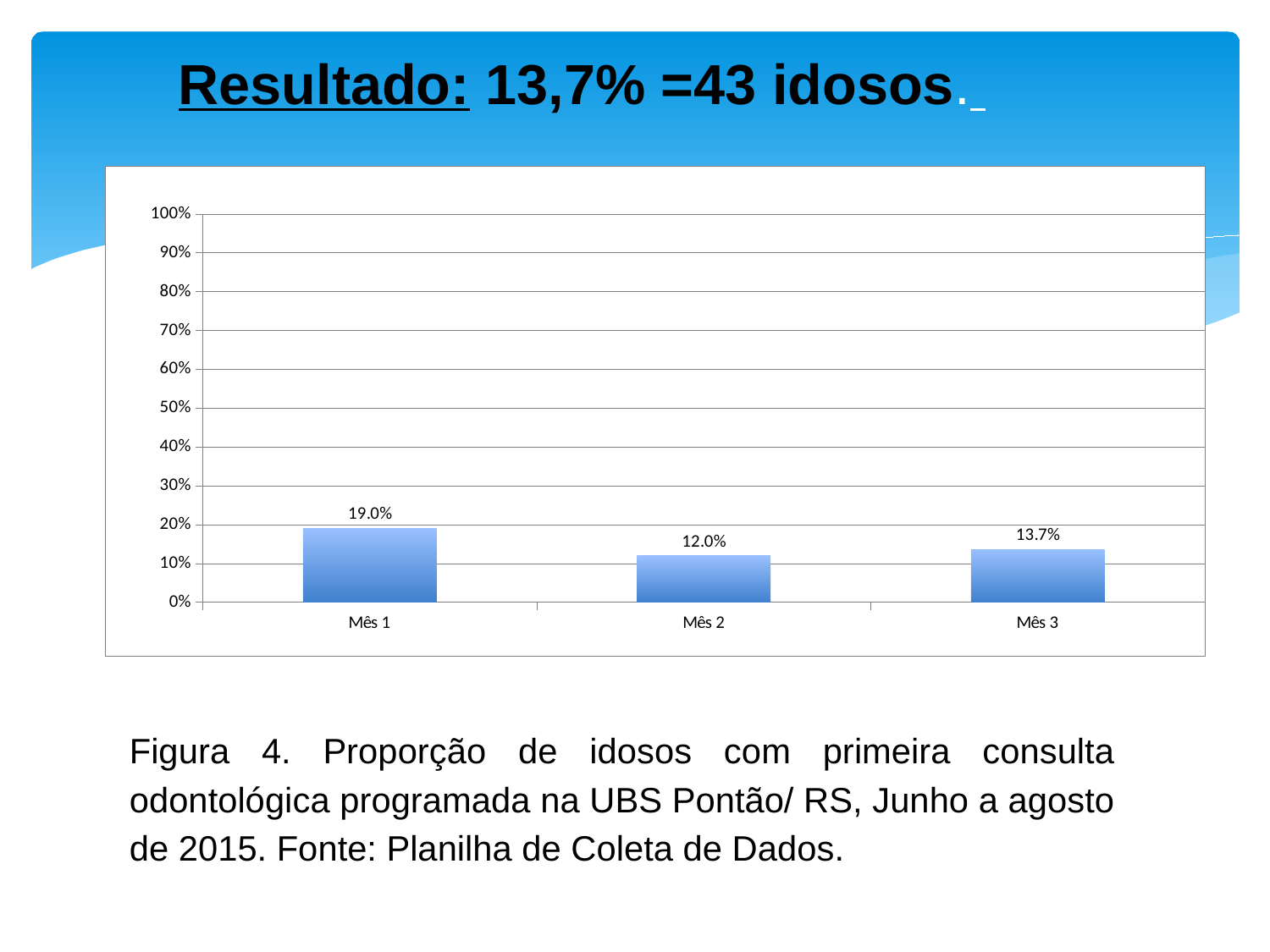
What is the value for Mês 2? 12.0% Which month has the highest value? Mês 1 What is the highest value shown on the y axis? 100% How many months are shown on the x axis? 3 What kind of chart is shown on the slide? bar chart What is the difference between the values for Mês 3 and Mês 2? 1.7% What is the value for Mês 3? 13.7% What is the value for Mês 1? 19.0% Which month has the lowest value? Mês 2 What is the difference between the values for Mês 1 and Mês 2? 7.0% Is the value for Mês 1 greater or less than 20%? less Which is larger, the value for Mês 1 or the value for Mês 3? Mês 1